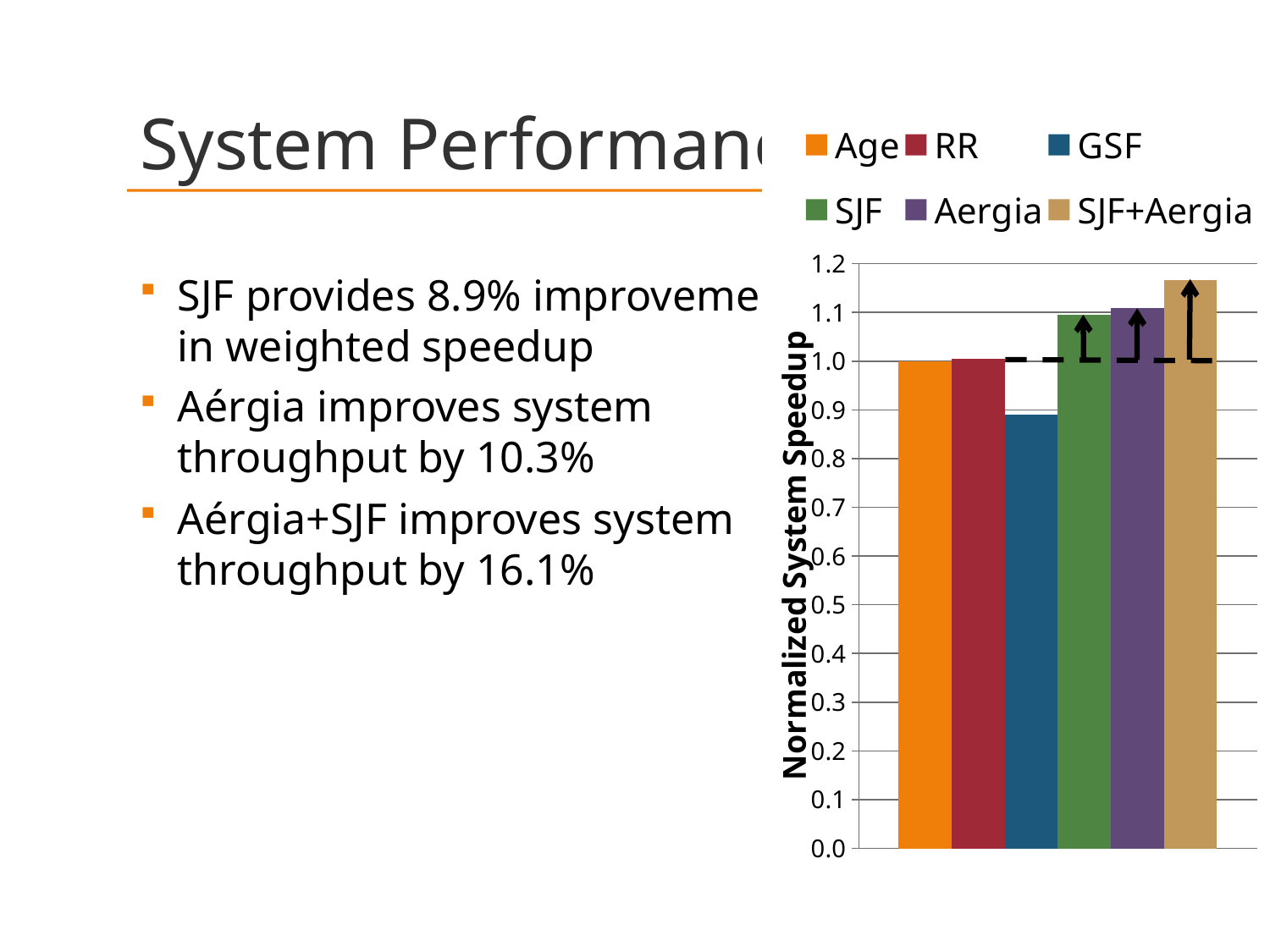
Is the value for GSF greater or less than 1.0? less What kind of chart is shown on the slide? bar chart Which is larger, the value for SJF or the value for GSF? SJF Which series has the highest normalized system speedup? SJF+Aergia How many series does the chart legend list? 6 Is the value for SJF greater or less than 1.0? greater What colour is the GSF bar in the chart? blue Which is larger, the value for SJF+Aergia or the value for Age? SJF+Aergia Is the value for GSF greater or less than 0.8? greater What is the title of the chart's vertical axis? Normalized System Speedup Which series has the lowest normalized system speedup? GSF